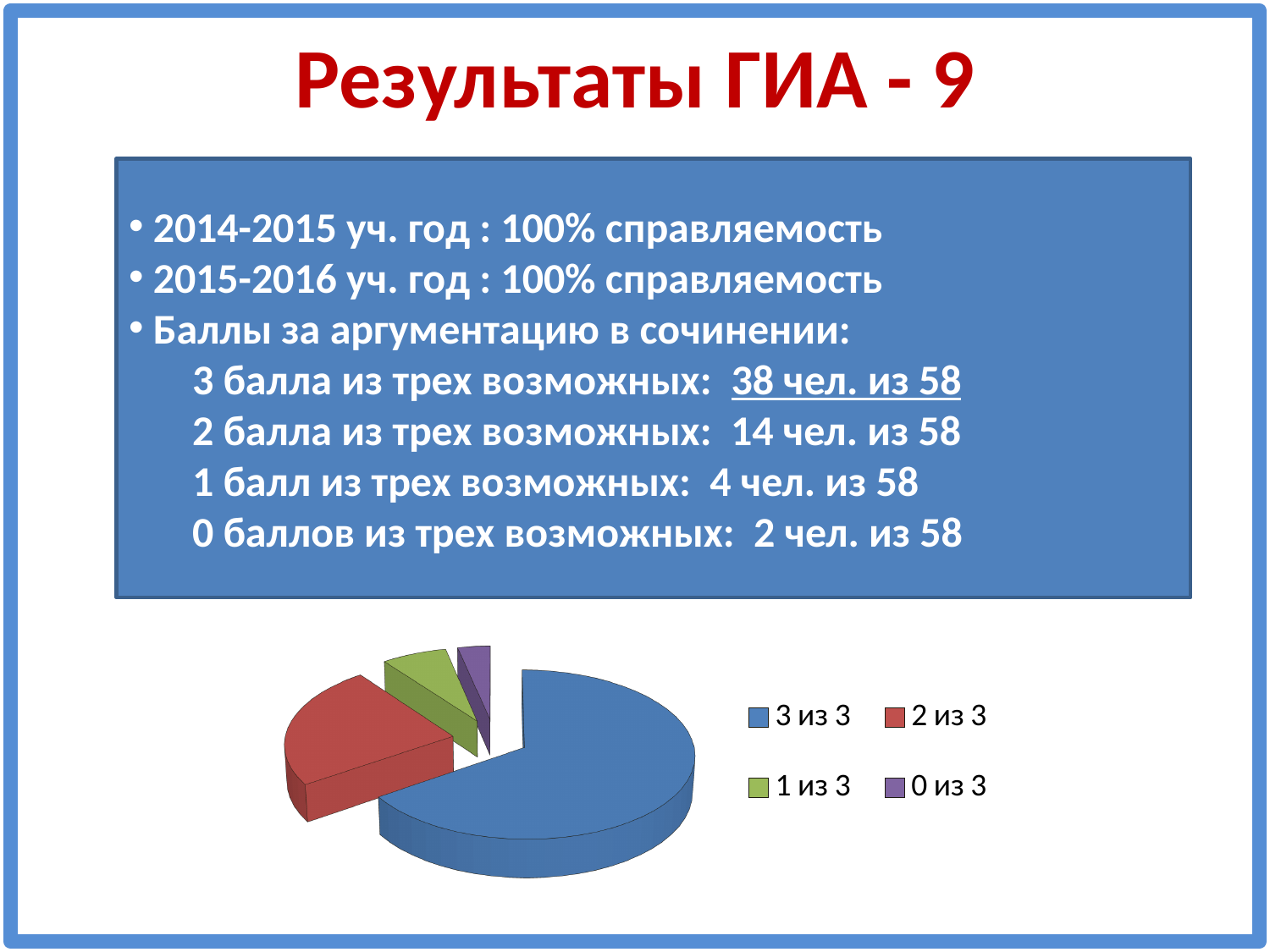
What colour is the "3 из 3" slice in the pie chart? blue How many entries does the legend of the pie chart list? 4 According to the slide, how many students correspond to the "3 из 3" slice of the pie chart? 38 чел. из 58 Which category has the largest slice in the pie chart? 3 из 3 According to the slide, how many students correspond to the "2 из 3" slice of the pie chart? 14 чел. из 58 According to the slide, how many students correspond to the "0 из 3" slice of the pie chart? 2 чел. из 58 How many slices does the pie chart have? 4 Which slice is larger in the pie chart, "2 из 3" or "1 из 3"? 2 из 3 What colour is the "0 из 3" slice in the pie chart? purple Which slice is larger in the pie chart, "1 из 3" or "0 из 3"? 1 из 3 Which category has the smallest slice in the pie chart? 0 из 3 What kind of chart is shown on the slide? pie chart